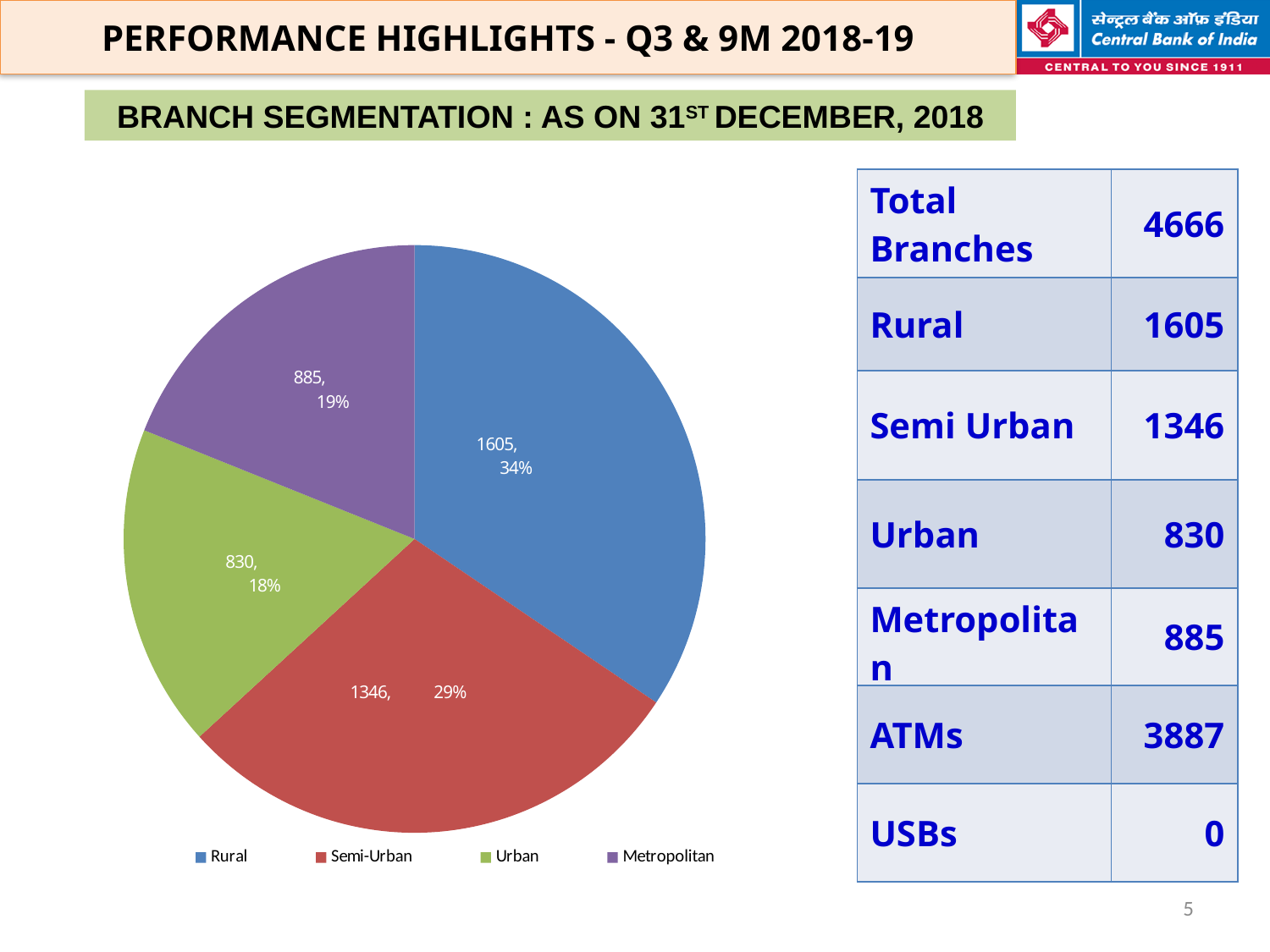
What percentage share does the Rural slice have in the pie chart? 34% How many slices does the pie chart have? 4 How many branches are in the Rural segment according to the pie chart? 1605 What percentage share does the Metropolitan slice have in the pie chart? 19% What colour is the Semi-Urban slice in the pie chart? red What value is shown for the Semi-Urban slice of the pie chart? 1346 Which segment has the smallest slice in the pie chart? Urban Which is larger in the pie chart, Metropolitan or Urban? Metropolitan Which segment has the largest slice in the pie chart? Rural What value is shown for the Urban slice of the pie chart? 830 What kind of chart is shown on the slide? pie chart What is the difference between the Rural and Semi-Urban values in the pie chart? 259